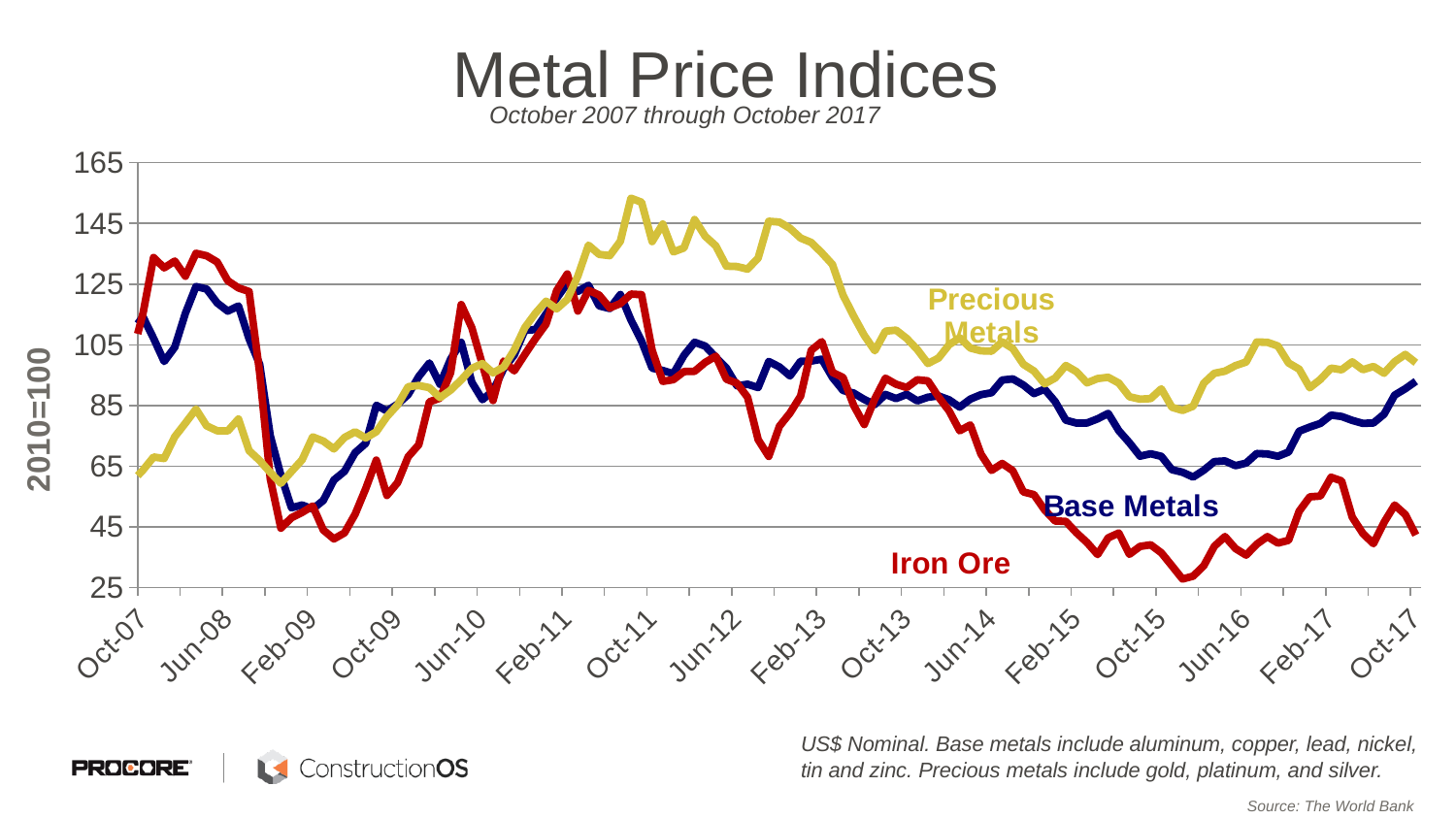
Is the value for Base Metals at Oct-17 greater or less than 85? greater Is the value for Precious Metals at Oct-11 greater or less than 125? greater At Oct-07, which is higher: Iron Ore or Precious Metals? Iron Ore Which series has the lowest value at Oct-15? Iron Ore What kind of chart is shown on the slide? line chart What is the label on the vertical axis? 2010=100 At Oct-17, which is higher: Precious Metals or Iron Ore? Precious Metals Is the value for Iron Ore at Oct-15 greater or less than 45? less How many series are plotted on the chart? 3 Does the Iron Ore line rise or fall between Feb-13 and Oct-15? fall What is the title of the chart? Metal Price Indices